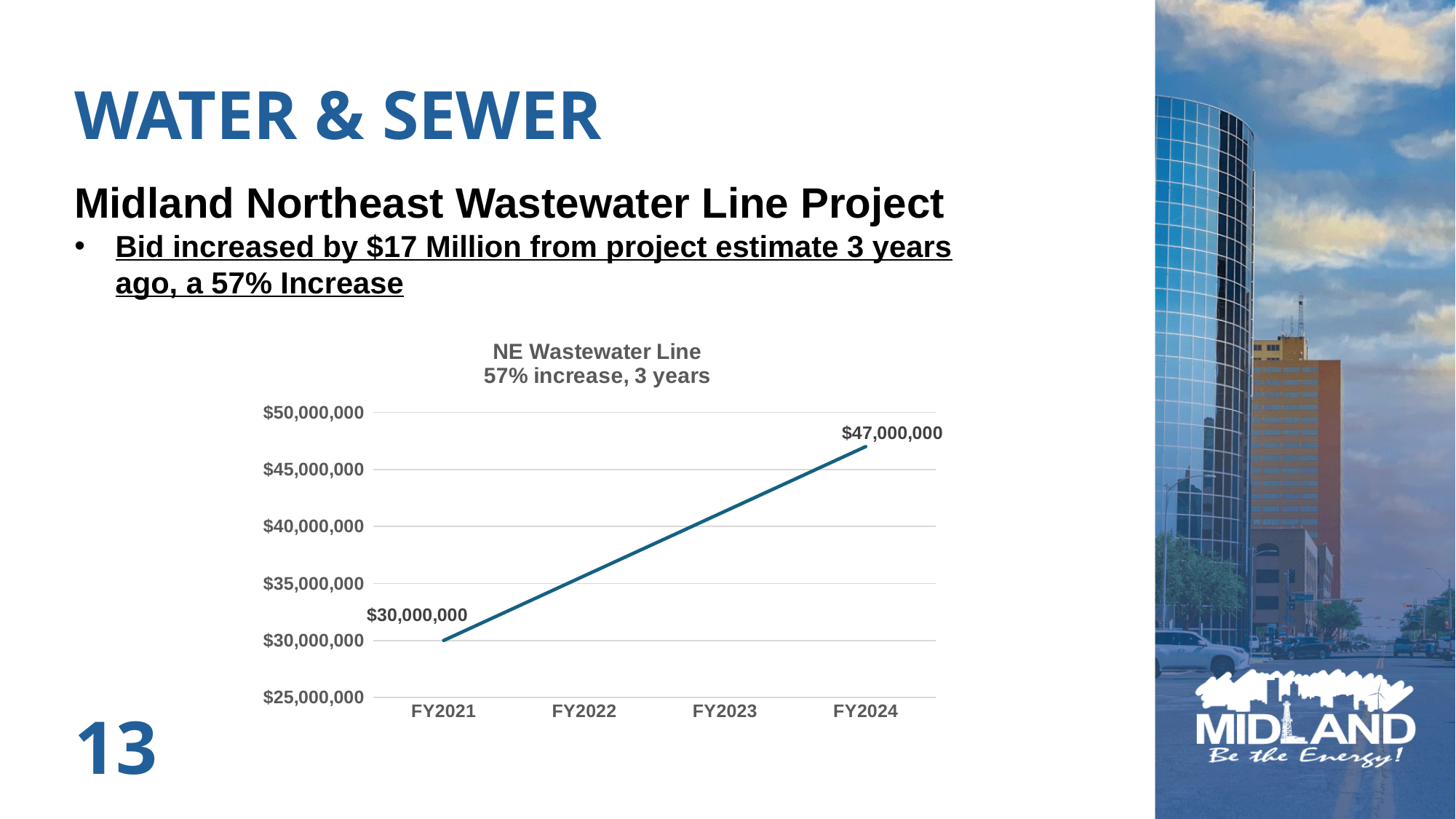
Which fiscal year on the x axis has the highest value on the chart? FY2024 What is the title of the chart on the slide? NE Wastewater Line 57% increase, 3 years What is the value shown for FY2021 on the NE Wastewater Line chart? $30,000,000 Which is larger on the chart, the FY2021 value or the FY2024 value? FY2024 Is the value of the line at FY2022 greater or less than $40,000,000? less By how much does the FY2024 value exceed the FY2021 value on the chart? $17,000,000 Is the value of the line at FY2023 greater or less than $45,000,000? less How many fiscal years are labeled on the x axis of the chart? 4 What kind of chart is shown on the slide? line chart What is the value shown for FY2024 on the NE Wastewater Line chart? $47,000,000 Do the values on the chart rise or fall from FY2021 to FY2024? rise Which fiscal year on the x axis has the lowest value on the chart? FY2021